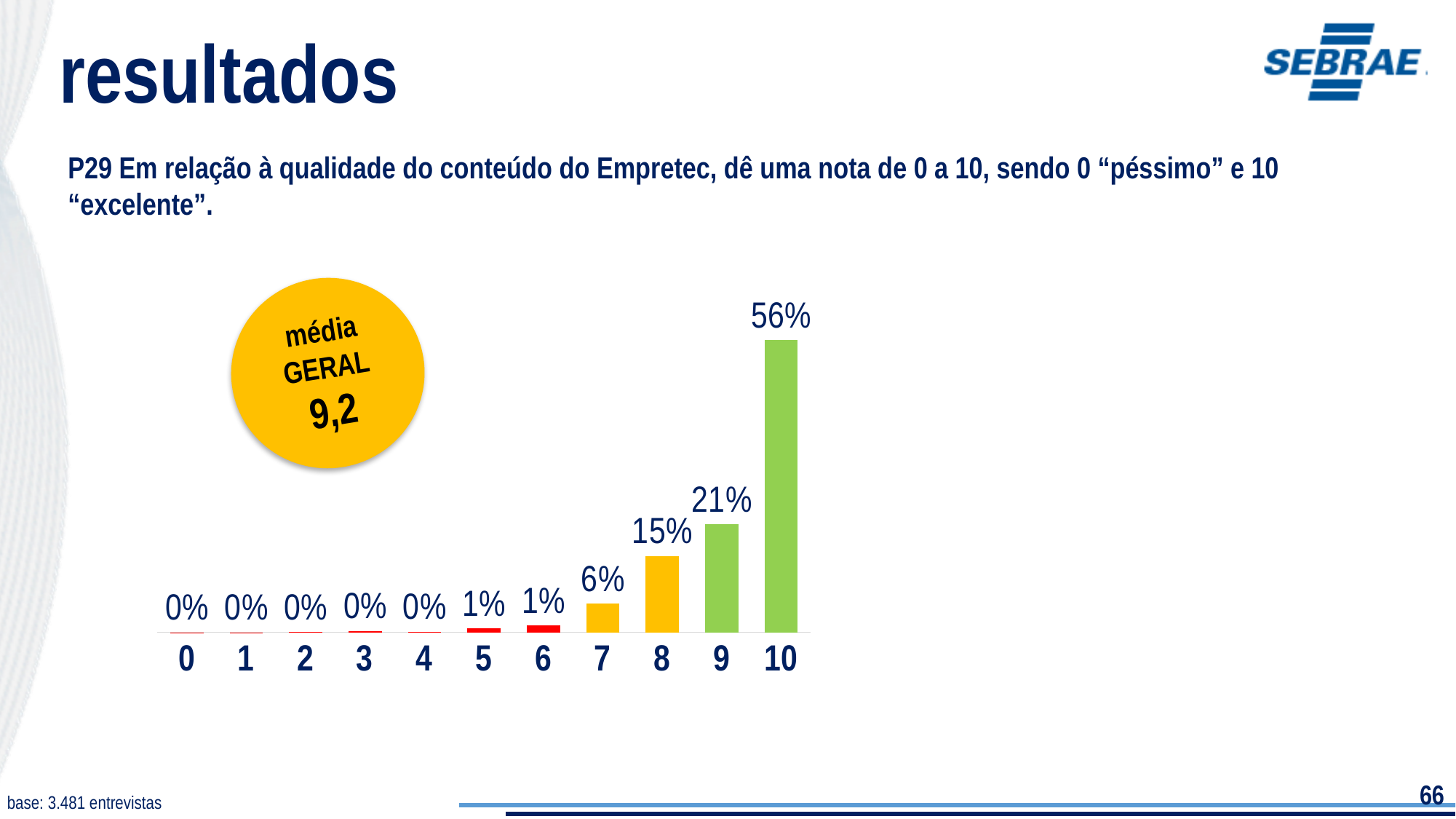
What is the overall average (média GERAL) shown in the yellow circle? 9,2 Which score received the highest percentage of responses? 10 What percentage of respondents gave a score of 8? 15% What kind of chart is shown on the slide? Bar chart Which score has a larger percentage, 7 or 8? 8 What is the difference in percentage points between the scores of 10 and 9? 35 What is the difference in percentage points between the scores of 9 and 8? 6 How many score categories are shown on the x axis? 11 What percentage of respondents gave a score of 9? 21% What percentage of respondents gave a score of 7? 6% Do the percentages rise or fall as the score increases from 5 to 10? Rise What percentage of respondents gave a score of 10? 56%